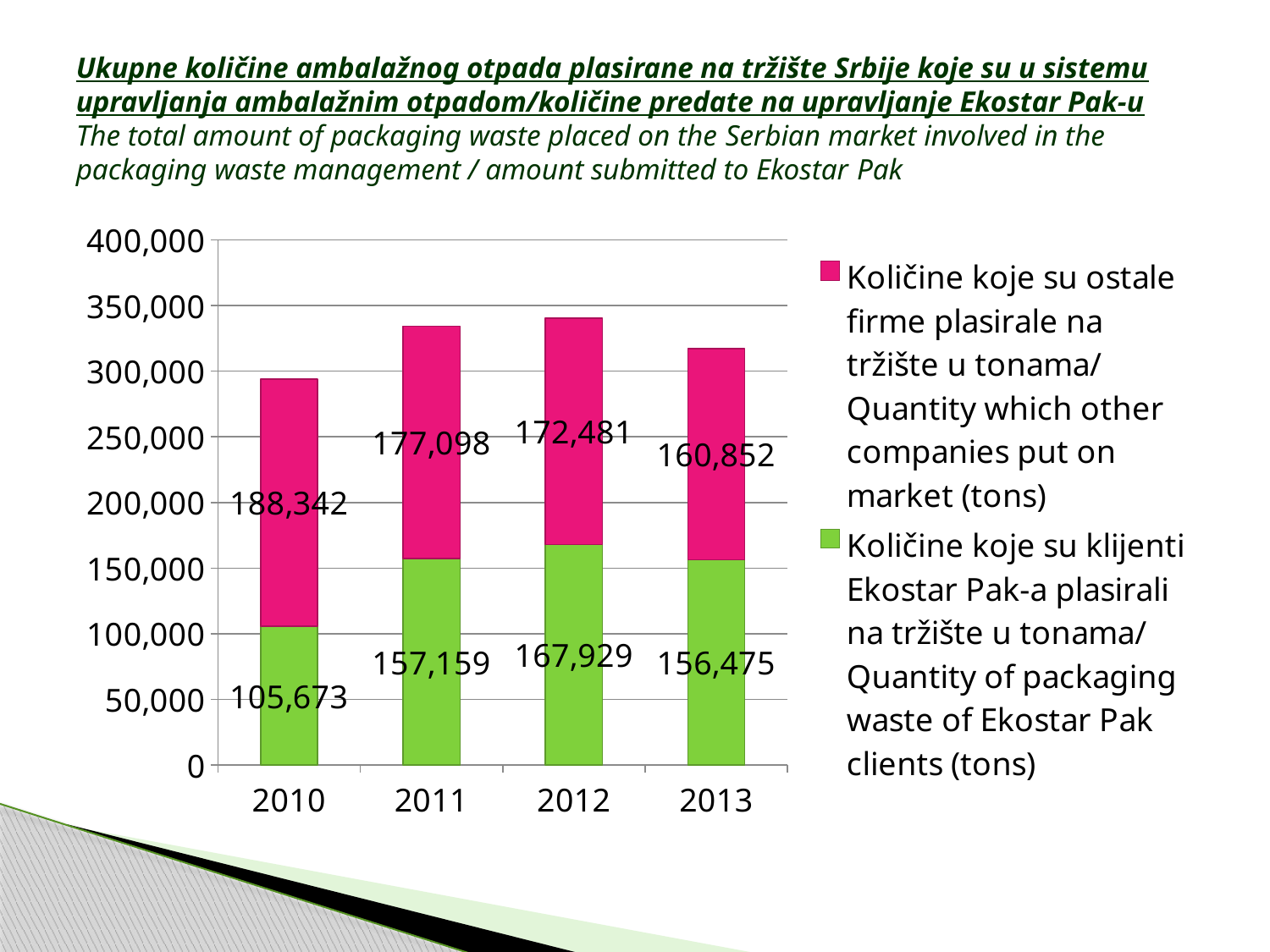
What is the total quantity put on the market in 2012 (both series combined)? 340,410 Which was larger in 2011: the quantity put on the market by other companies or by Ekostar Pak clients? Other companies In which year was the quantity put on the market by Ekostar Pak clients highest? 2012 How many years are shown on the x axis of the chart? 4 In which year was the quantity put on the market by other companies lowest? 2013 What quantity did Ekostar Pak clients put on the market in 2010? 105,673 What type of chart is shown on the slide? Stacked bar chart What quantity did other companies put on the market in 2012? 172,481 How many series does the chart legend list? 2 What is the difference between the quantity put on the market by other companies and by Ekostar Pak clients in 2010? 82,669 What quantity did Ekostar Pak clients put on the market in 2013? 156,475 What is the total quantity put on the market in 2010 (both series combined)? 294,015